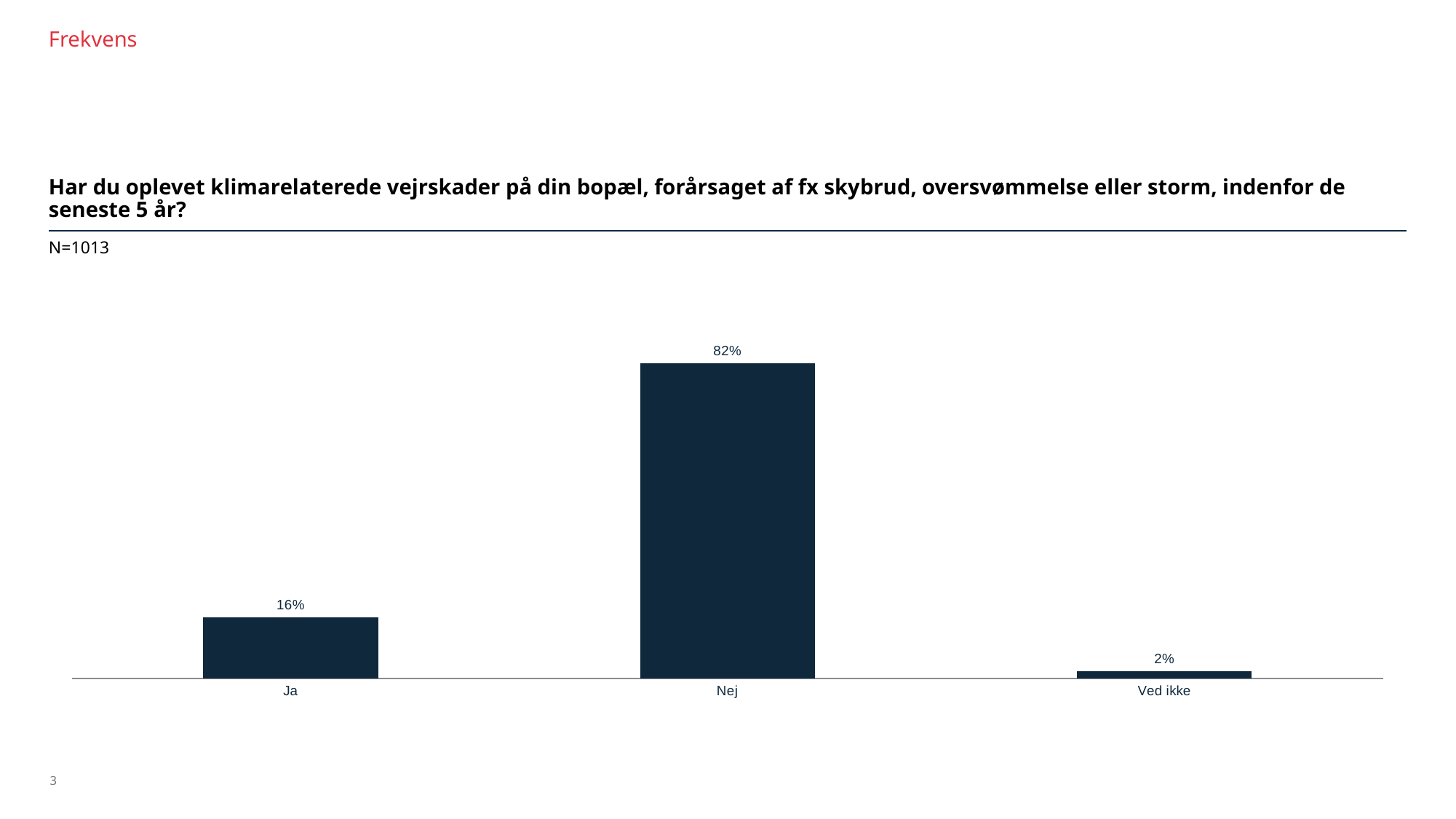
Which is larger, the value for "Ja" or the value for "Ved ikke"? Ja What is the total of the three values shown on the chart? 100% What is the sample size (N) stated on the slide? N=1013 How many categories are shown on the chart? 3 Which category has the lowest value? Ved ikke Which category has the highest value? Nej What is the difference between the values for "Nej" and "Ja"? 66% What is the difference between the values for "Ja" and "Ved ikke"? 14% What is the value for "Ved ikke"? 2% What kind of chart is shown on the slide? Bar chart What is the value for "Nej"? 82% What is the value for "Ja"? 16%